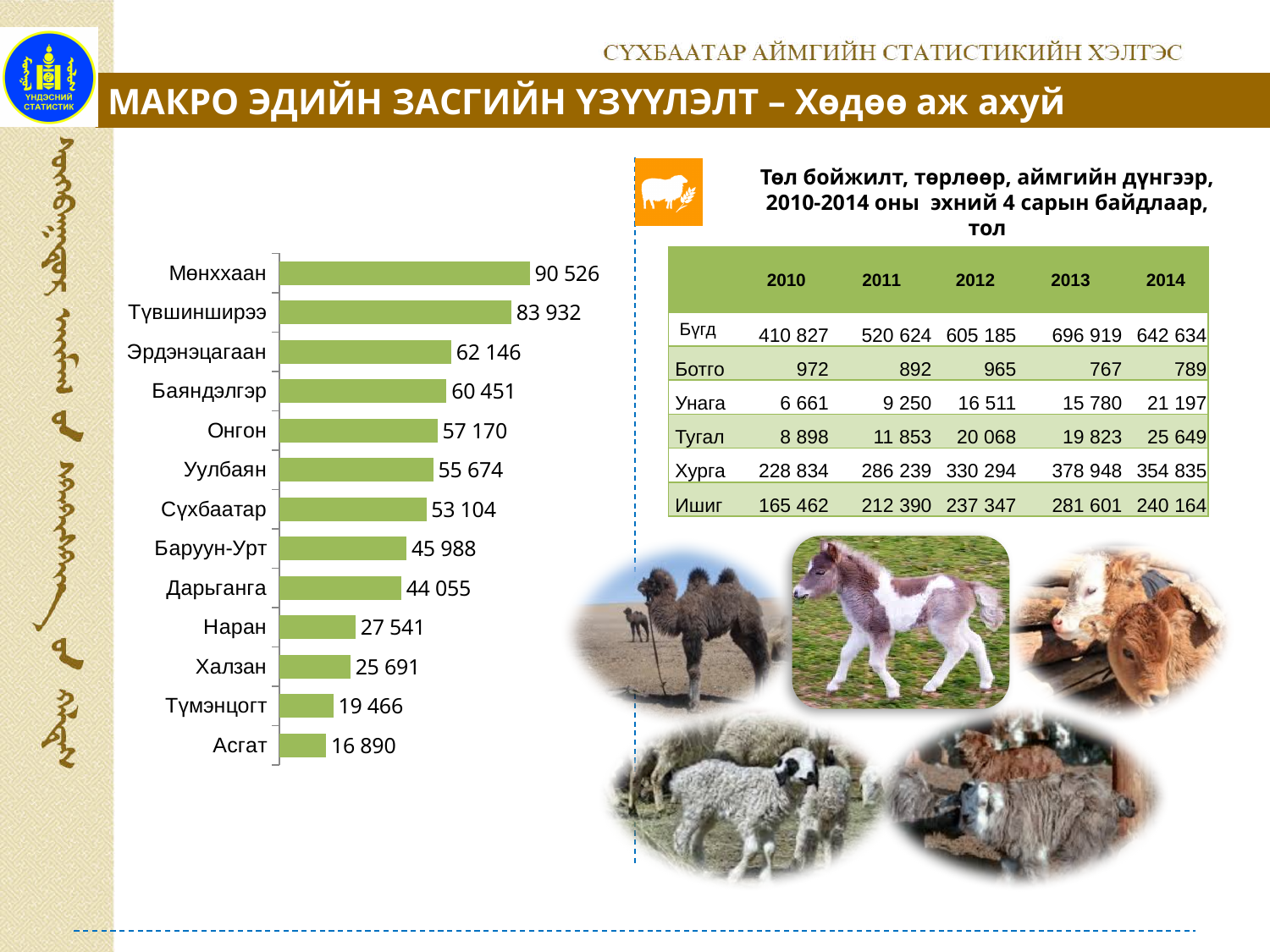
Which category has the highest value in the bar chart? Мөнххаан What is the difference between the values for Наран and Халзан in the bar chart? 1 850 What is the value for Мөнххаан in the bar chart? 90 526 How many categories are shown in the bar chart? 13 What is the value for Дарьганга in the bar chart? 44 055 What type of chart is shown on the left of the slide? Bar chart What is the difference between the values for Мөнххаан and Түвшинширээ in the bar chart? 6 594 Which category has the lowest value in the bar chart? Асгат Which has a larger value in the bar chart, Эрдэнэцагаан or Уулбаян? Эрдэнэцагаан What is the value for Сүхбаатар in the bar chart? 53 104 What is the value for Түмэнцогт in the bar chart? 19 466 Which has a larger value in the bar chart, Онгон or Баруун-Урт? Онгон